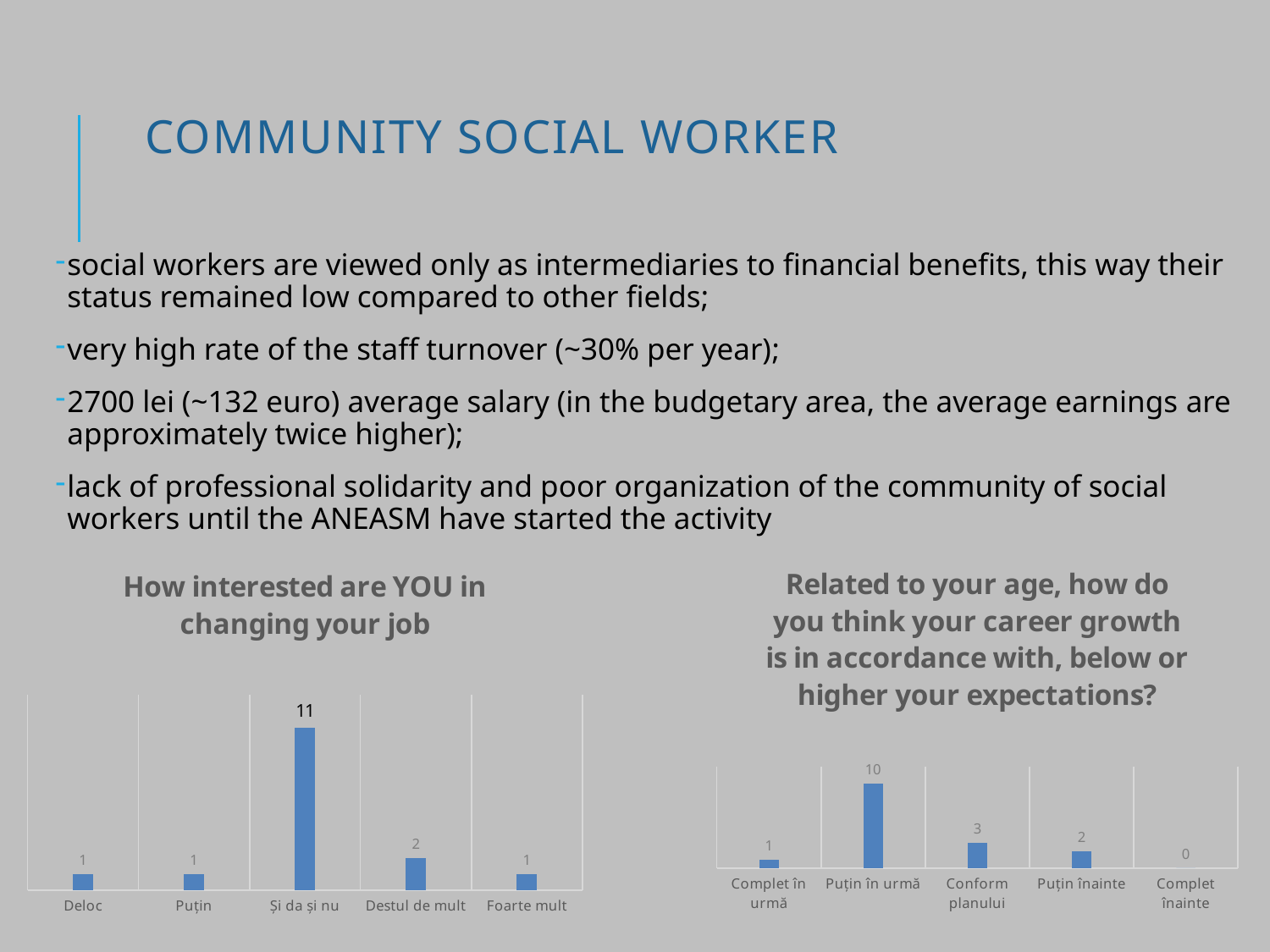
In the chart on the right about career growth expectations, what is the value for "Conform planului"? 3 In the chart on the right about career growth expectations, which is larger: the value for "Conform planului" or the value for "Puțin înainte"? Conform planului In the chart titled "How interested are YOU in changing your job", how many categories are shown on the x axis? 5 In the chart titled "How interested are YOU in changing your job", what is the value for "Și da și nu"? 11 What kind of chart is the chart titled "How interested are YOU in changing your job"? Bar chart In the chart on the right about career growth expectations, what is the difference between the values for "Puțin în urmă" and "Complet în urmă"? 9 In the chart on the right about career growth expectations, which category has the lowest value? Complet înainte In the chart on the right about career growth expectations, what is the value for "Puțin în urmă"? 10 In the chart titled "How interested are YOU in changing your job", what is the value for "Destul de mult"? 2 In the chart titled "How interested are YOU in changing your job", which category has the highest value? Și da și nu In the chart titled "How interested are YOU in changing your job", what is the difference between the values for "Și da și nu" and "Destul de mult"? 9 In the chart on the right about career growth expectations, how many categories are shown on the x axis? 5